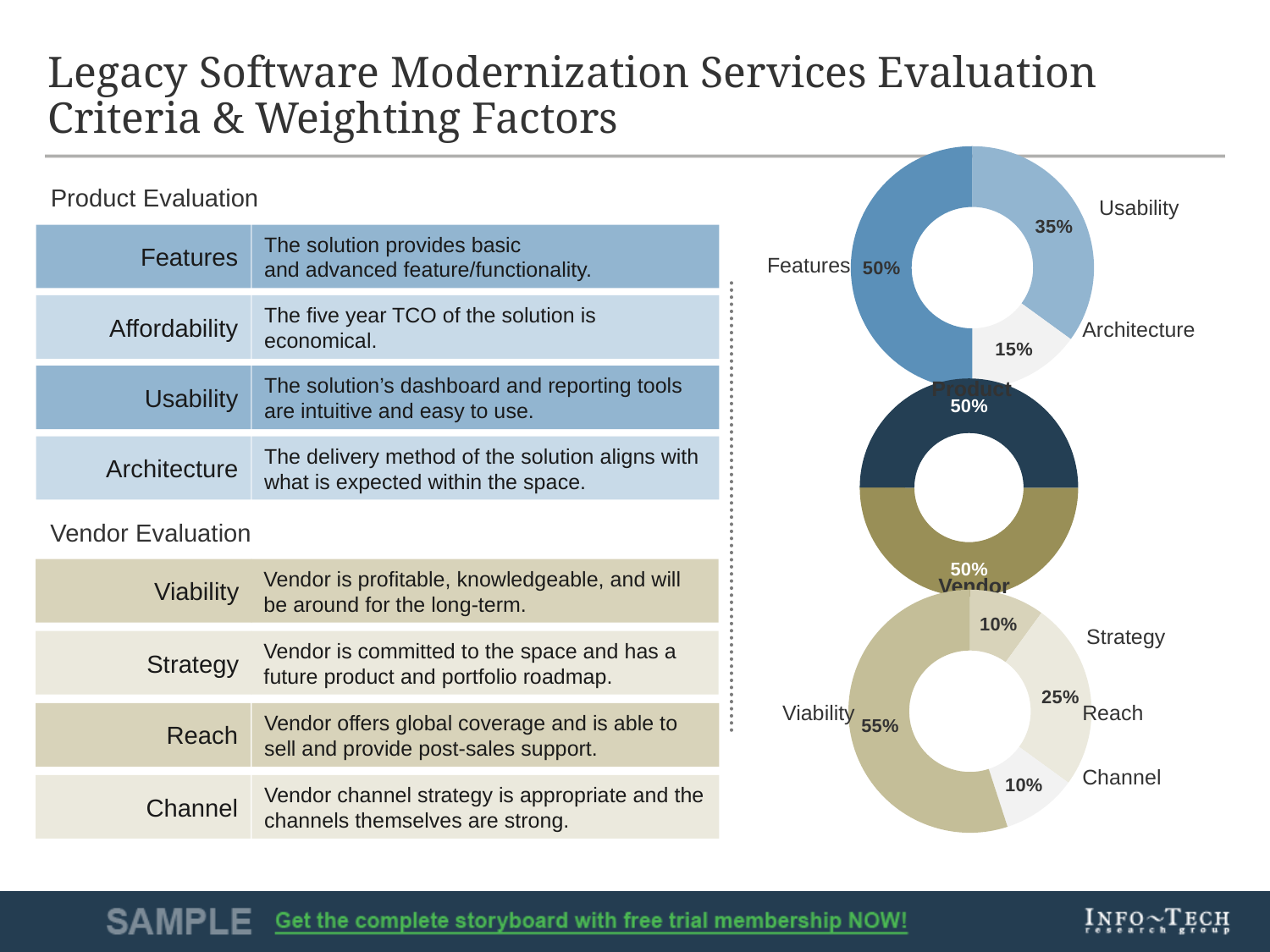
In the top donut chart, what is the value for Features? 50% In the top donut chart, what is the value for Usability? 35% In the top donut chart, what is the value for Architecture? 15% In the middle donut chart, what is the value for Vendor? 50% What type of chart is used on the right side of the slide? Donut (pie) chart In the bottom donut chart, what is the value for Viability? 55% In the top donut chart, what is the difference between the Features and Usability values? 15% In the bottom donut chart, which category has the largest share? Viability In the top donut chart, which category has the smallest share? Architecture In the bottom donut chart, which is larger, Reach or Strategy? Reach In the bottom donut chart, what is the value for Reach? 25% In the bottom donut chart, how many categories are shown? 4